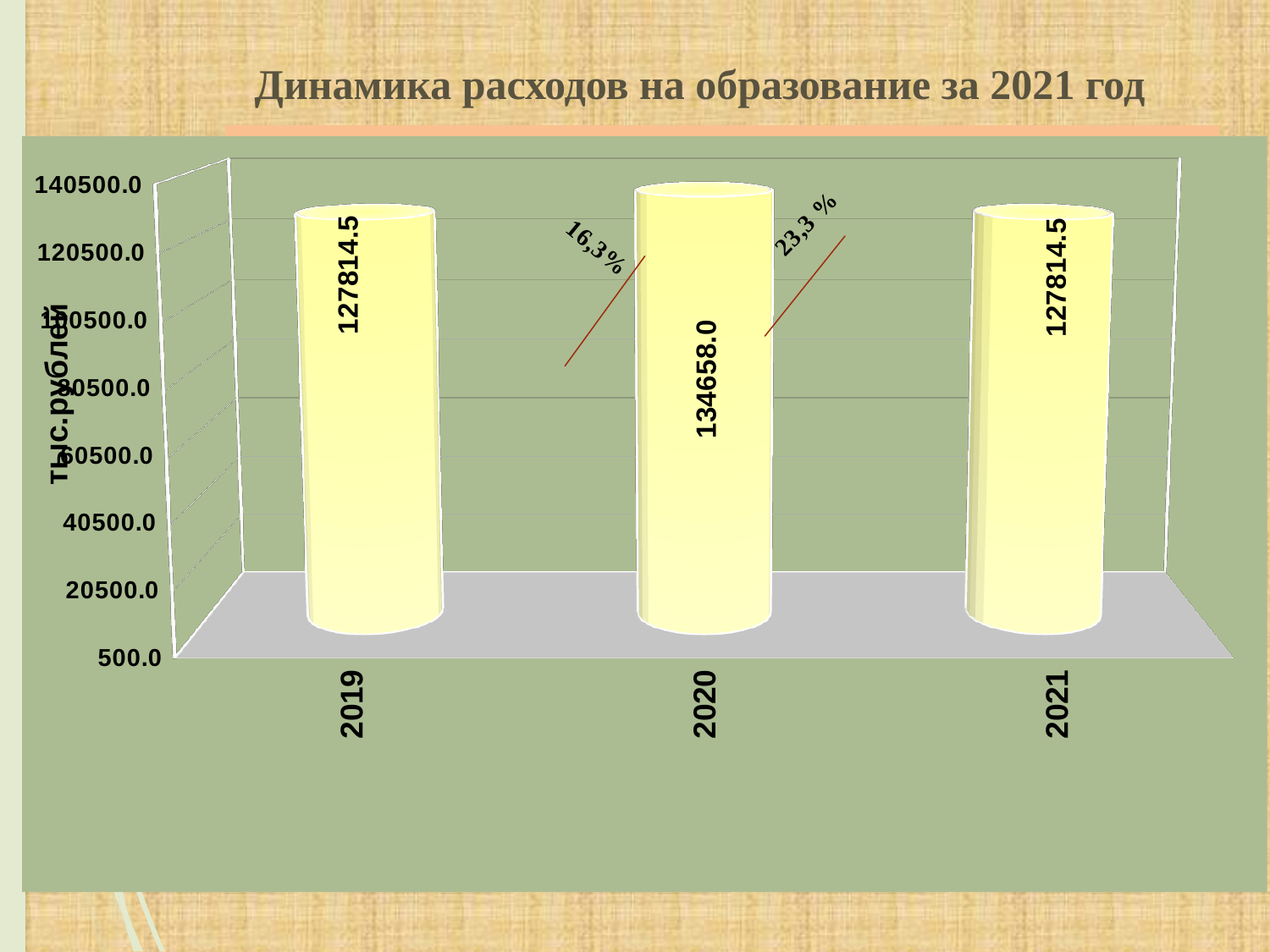
What is the value for 2019? 127814.5 What is the value for 2021? 127814.5 Is the value for 2020 greater or less than 140500.0? less Which year has the highest value? 2020 Which is larger, the value for 2020 or the value for 2021? 2020 What is the value for 2020? 134658.0 What is the difference between the values for 2020 and 2019? 6843.5 What is the title of the chart? Динамика расходов на образование за 2021 год What is the label of the vertical axis? тыс.рублей What kind of chart is shown on the slide? bar chart How many years are shown on the x axis? 3 Is the value for 2019 greater or less than 120500.0? greater